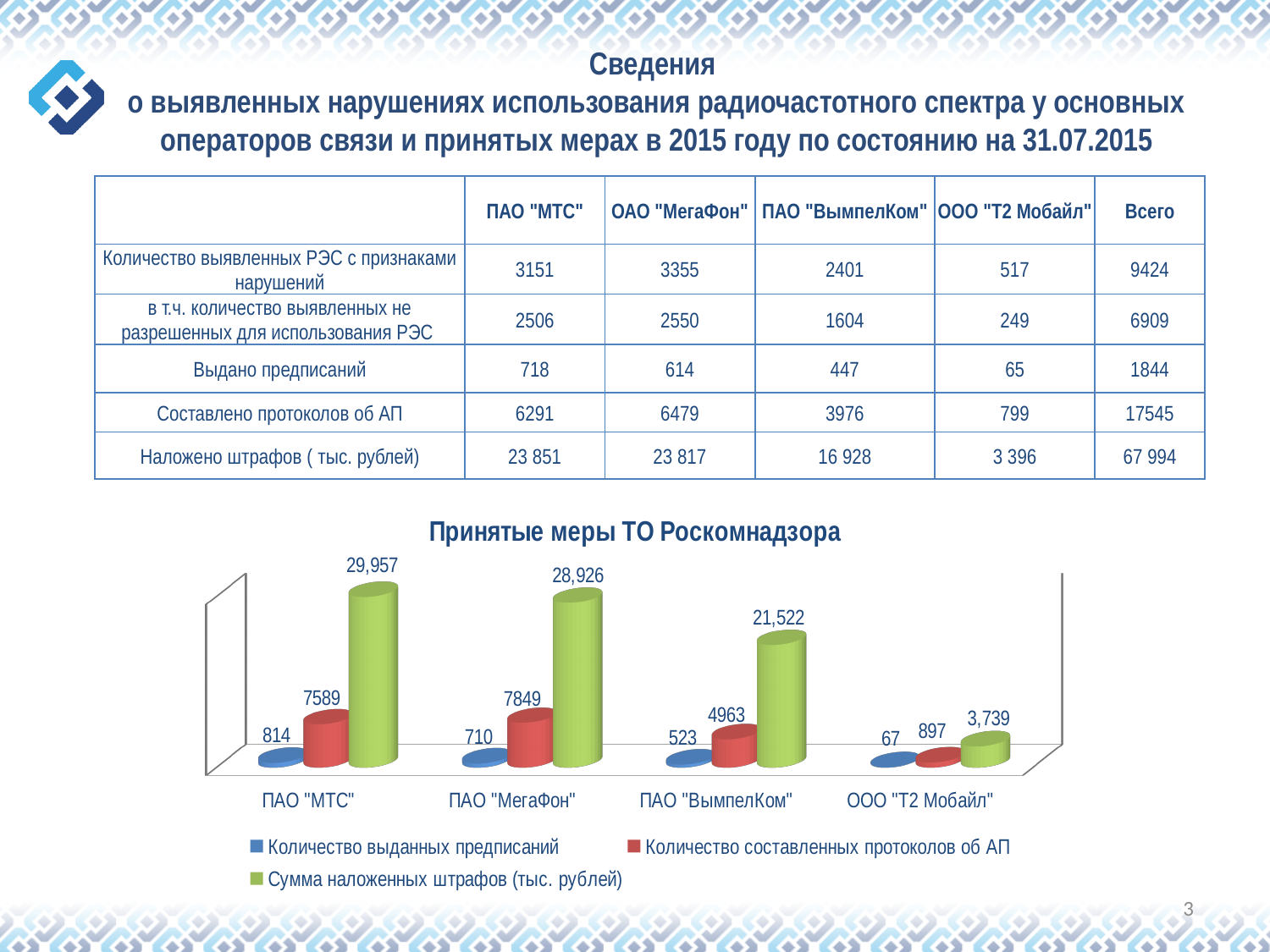
In the chart "Принятые меры ТО Роскомнадзора", what is the value of "Сумма наложенных штрафов (тыс. рублей)" for ПАО "МТС"? 29,957 How many operators (categories) are shown in the chart "Принятые меры ТО Роскомнадзора"? 4 How many series does the legend of the chart "Принятые меры ТО Роскомнадзора" list? 3 In the chart "Принятые меры ТО Роскомнадзора", what is the value of "Количество составленных протоколов об АП" for ПАО "МегаФон"? 7849 In the chart "Принятые меры ТО Роскомнадзора", which is larger: "Количество составленных протоколов об АП" for ПАО "МТС" or for ПАО "МегаФон"? ПАО "МегаФон" In the chart "Принятые меры ТО Роскомнадзора", which operator has the highest "Сумма наложенных штрафов (тыс. рублей)"? ПАО "МТС" In the chart "Принятые меры ТО Роскомнадзора", what is the value of "Количество выданных предписаний" for ООО "Т2 Мобайл"? 67 What kind of chart is "Принятые меры ТО Роскомнадзора"? Bar chart In the chart "Принятые меры ТО Роскомнадзора", what is the difference in "Количество выданных предписаний" between ПАО "МТС" and ПАО "МегаФон"? 104 In the chart "Принятые меры ТО Роскомнадзора", what is the value of "Сумма наложенных штрафов (тыс. рублей)" for ПАО "ВымпелКом"? 21,522 In the chart "Принятые меры ТО Роскомнадзора", which operator has the lowest "Количество составленных протоколов об АП"? ООО "Т2 Мобайл" In the chart "Принятые меры ТО Роскомнадзора", what colour are the bars for "Сумма наложенных штрафов (тыс. рублей)"? Green